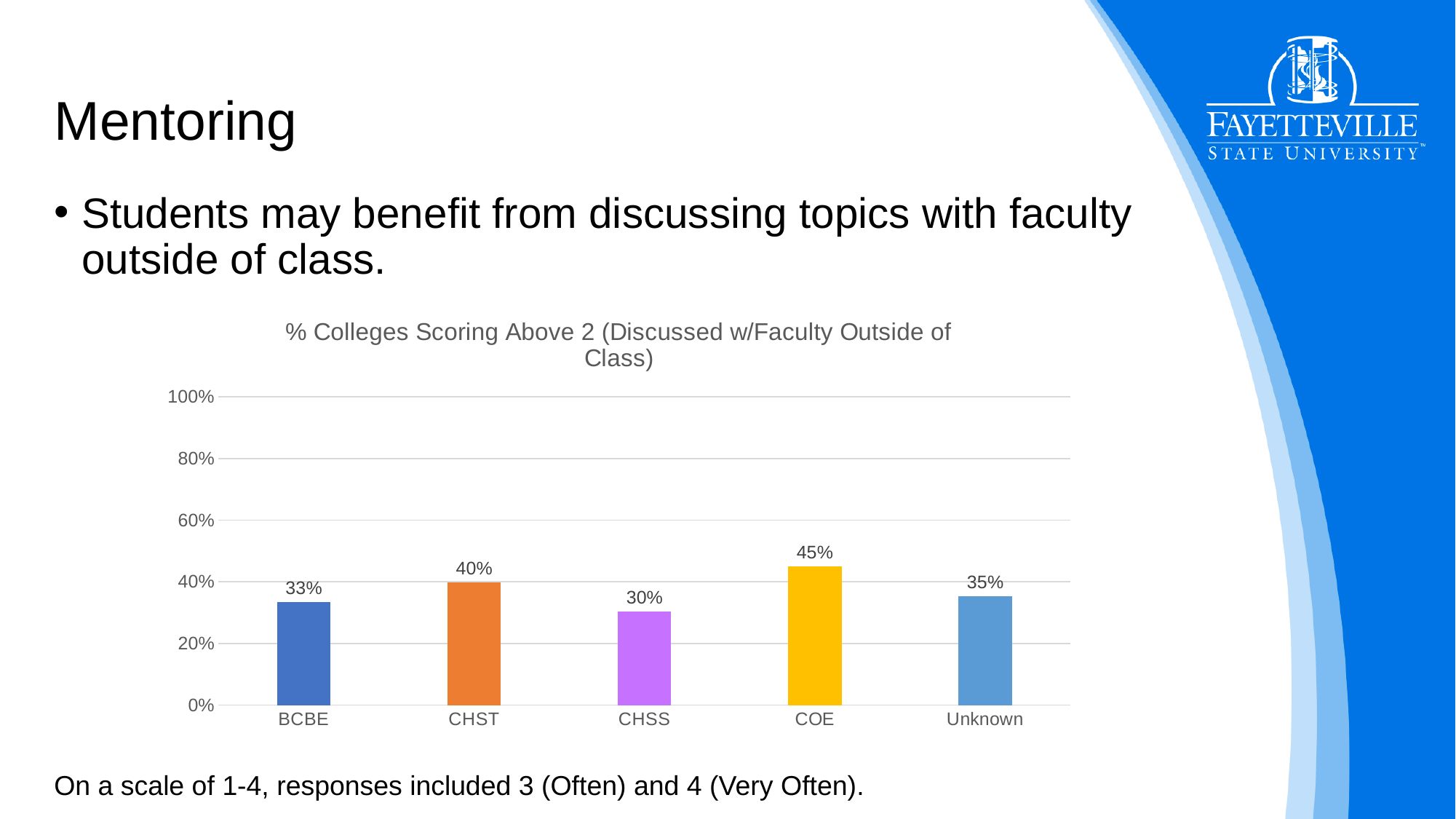
Which category has the highest value? COE How many categories are shown on the x axis? 5 What is the difference between the values for COE and CHSS? 15% What is the title of the chart? % Colleges Scoring Above 2 (Discussed w/Faculty Outside of Class) Which is larger, the value for CHST or the value for Unknown? CHST What is the value for COE? 45% Which category has the lowest value? CHSS Is the value for COE greater or less than 40%? greater What is the value for BCBE? 33% What kind of chart is shown on the slide? bar chart What is the value for CHSS? 30% What is the value for Unknown? 35%